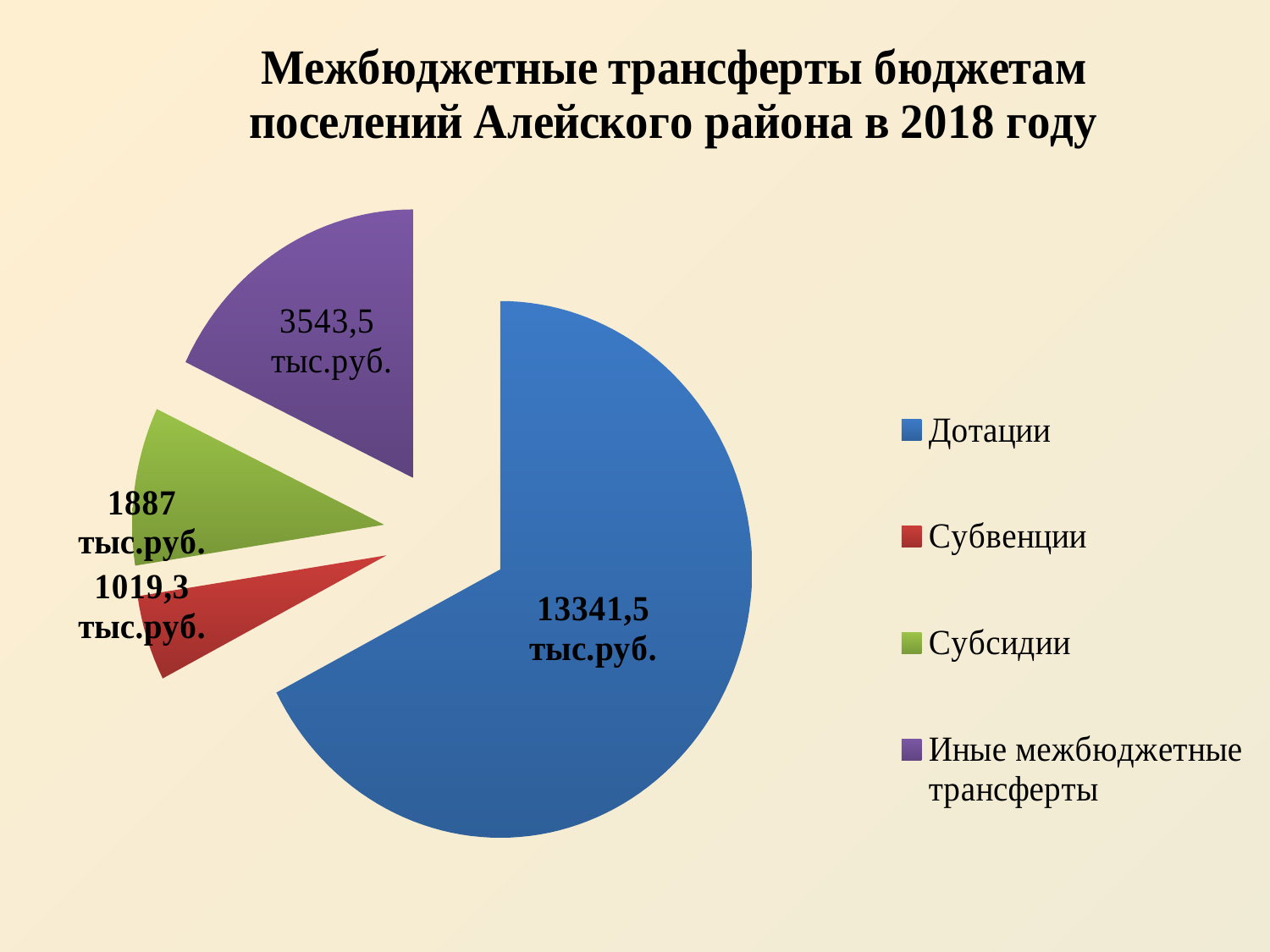
Which category has the largest slice of the pie? Дотации What is the value for Субвенции? 1019,3 тыс.руб. What is the value for Иные межбюджетные трансферты? 3543,5 тыс.руб. What colour is the slice for Субвенции? Red Which is larger, Субсидии or Иные межбюджетные трансферты? Иные межбюджетные трансферты What is the value for Субсидии? 1887 тыс.руб. What is the value for Дотации? 13341,5 тыс.руб. What is the difference between Субсидии and Субвенции? 867,7 тыс.руб. What type of chart is shown on the slide? Pie chart How many categories does the pie chart have? 4 Which category has the smallest slice of the pie? Субвенции What is the difference between Дотации and Иные межбюджетные трансферты? 9798 тыс.руб.